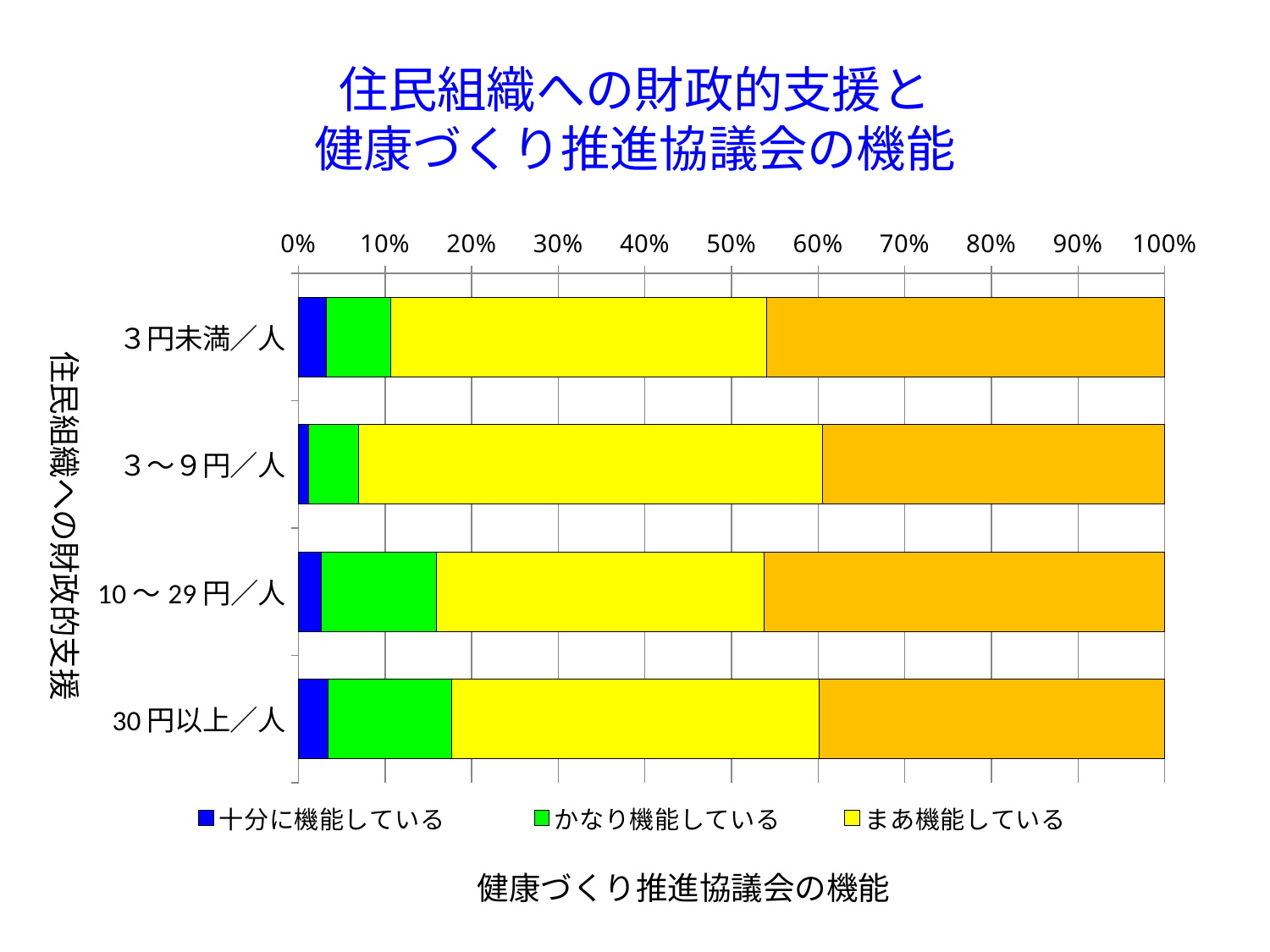
How many categories are shown on the vertical axis of the chart? 4 What kind of chart is shown on the slide? stacked bar chart What is the label of the vertical axis of the chart? 住民組織への財政的支援 Is the combined share of the first three legend series (up to the end of the yellow segment) for 10～29円／人 greater or less than 50%? greater Is the combined share of the first three legend series (up to the end of the yellow segment) for ３～９円／人 greater or less than 50%? greater Is the かなり機能している segment for ３～９円／人 greater or less than 10%? less Which category has the smallest 十分に機能している segment? ３～９円／人 How many series does the chart's legend list? 3 Which category has the larger かなり機能している segment, 10～29円／人 or ３～９円／人? 10～29円／人 What is the title of the chart on the slide? 住民組織への財政的支援と健康づくり推進協議会の機能